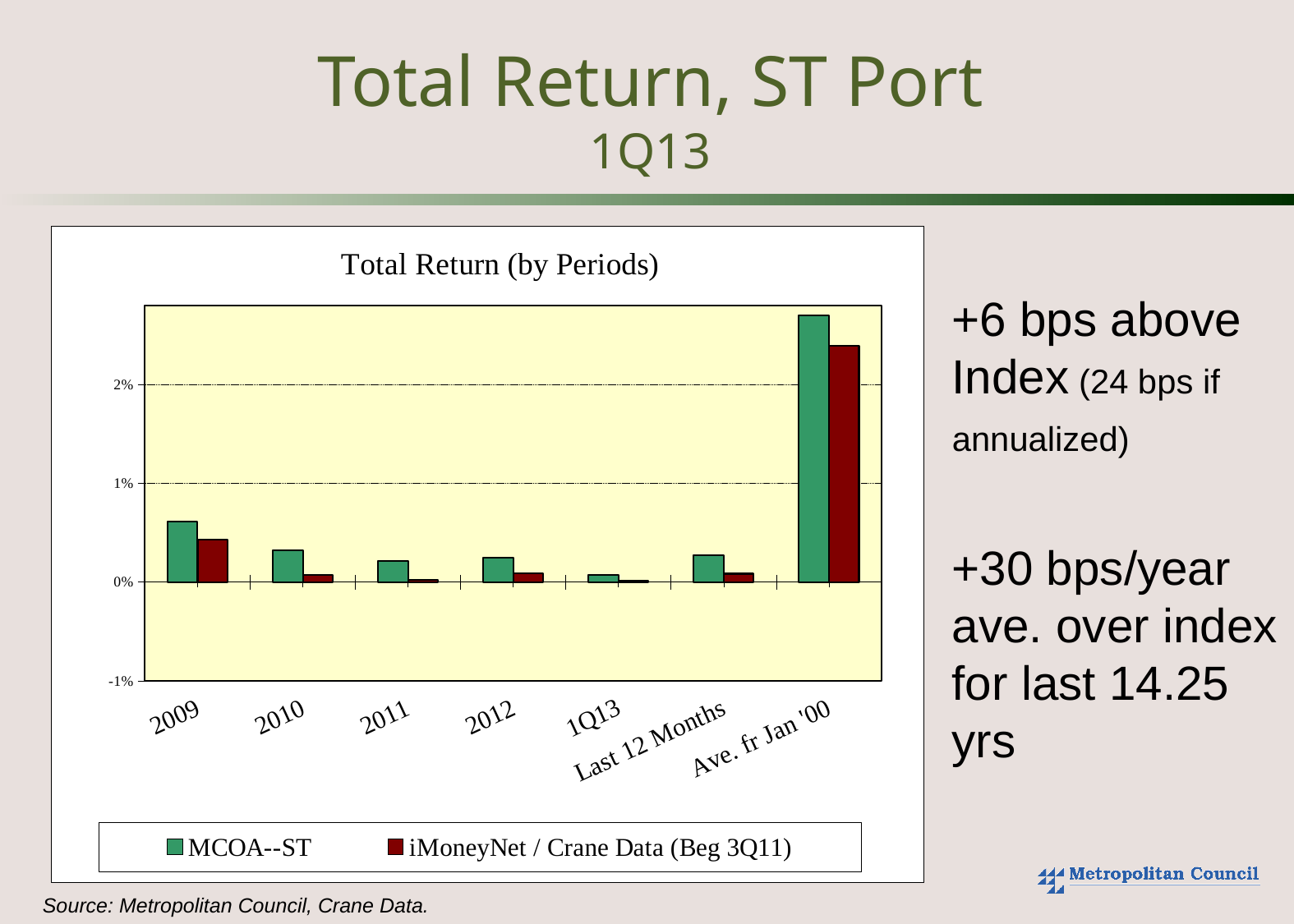
Which period has the larger MCOA--ST total return, 2009 or 2010? 2009 Is the iMoneyNet / Crane Data value for Ave. fr Jan '00 greater or less than 2%? greater What are the two series named in the chart legend? MCOA--ST and iMoneyNet / Crane Data (Beg 3Q11) What is the title of the chart? Total Return (by Periods) For which period is the MCOA--ST total return highest? Ave. fr Jan '00 Is the MCOA--ST value for 2009 greater or less than 1%? less In 2009, which series has the larger total return, MCOA--ST or iMoneyNet / Crane Data? MCOA--ST Is the MCOA--ST value for Ave. fr Jan '00 greater or less than 2%? greater For which period is the MCOA--ST total return lowest? 1Q13 What type of chart is shown on the slide? Bar chart How many period categories are shown along the x axis of the chart? 7 How many series does the chart legend list? 2